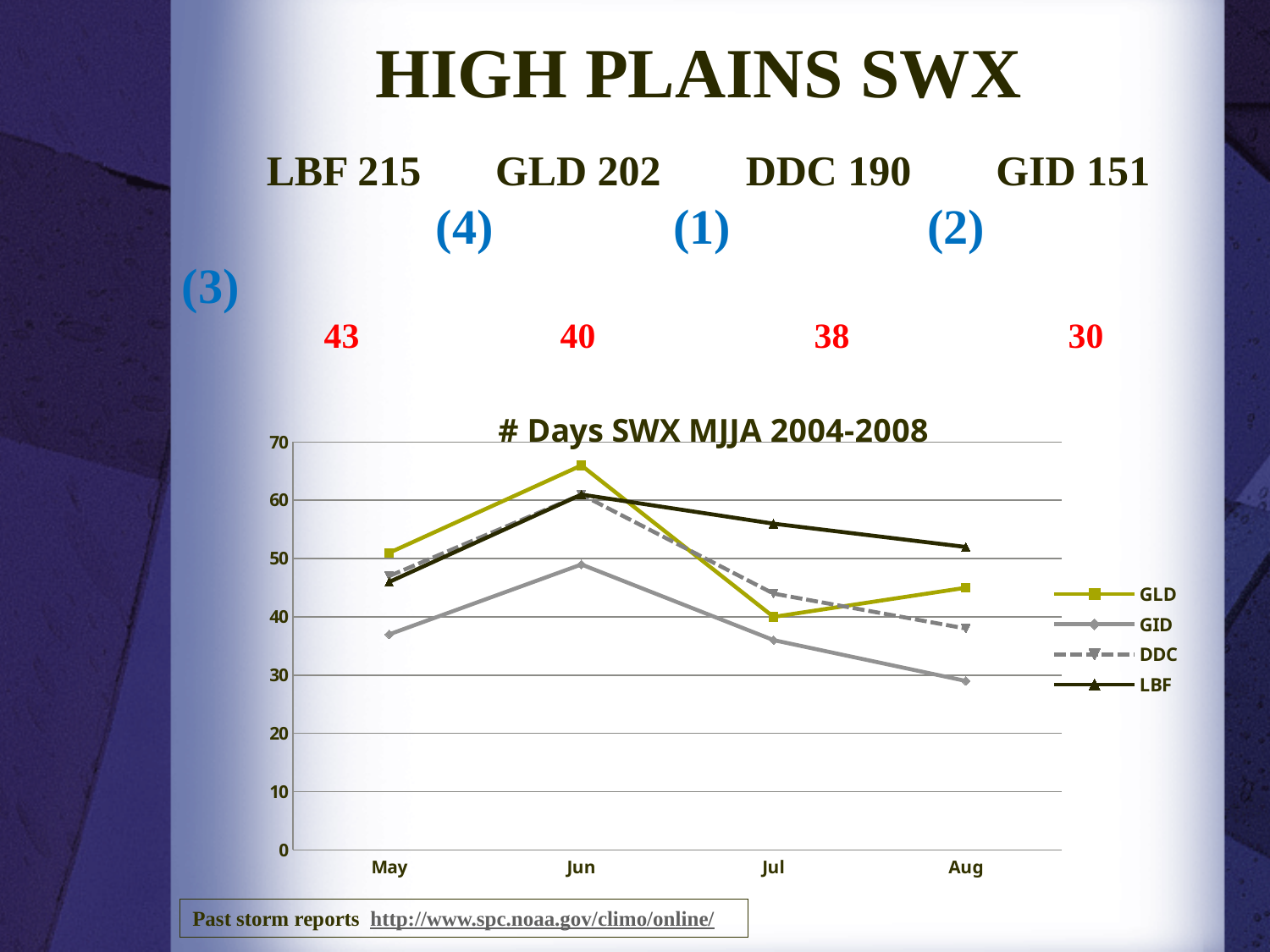
Does the GID series rise or fall from Jun to Aug? fall How many months are shown on the x axis of the chart? 4 What kind of chart is shown on the slide? line chart Is the value for GID in May greater or less than 40? less In which month does the GLD series reach its highest value? Jun How many series does the chart legend list? 4 Which series has the lowest value in Aug? GID Which series has the highest value in Jun? GLD Is the value for LBF in Jul greater or less than 50? greater What is the title of the chart? # Days SWX MJJA 2004-2008 Is the value for GLD in Jun greater or less than 60? greater In Jul, which series has the larger value, LBF or GID? LBF